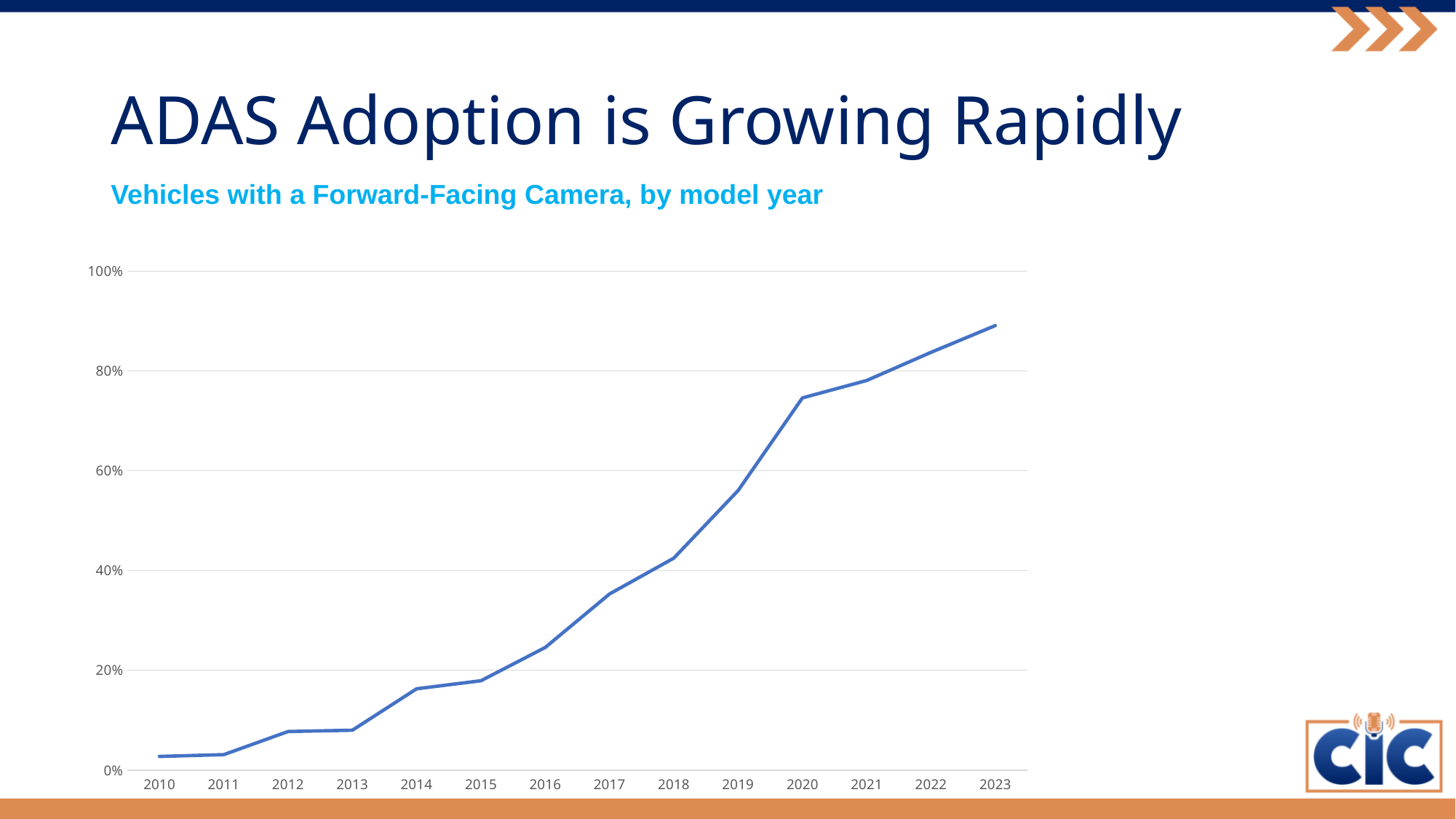
Is the value for 2012 greater or less than 20%? less Which is larger, the value for 2015 or the value for 2020? 2020 What is the subtitle describing the chart's data? Vehicles with a Forward-Facing Camera, by model year Is the value for 2019 greater or less than 40%? greater What kind of chart is shown on the slide? line chart Is the value for 2020 greater or less than 60%? greater What is the first model year shown on the x axis? 2010 Do the values generally rise or fall from 2010 to 2023? rise How many model years are plotted on the x axis? 14 Which model year has the highest share of vehicles with a forward-facing camera? 2023